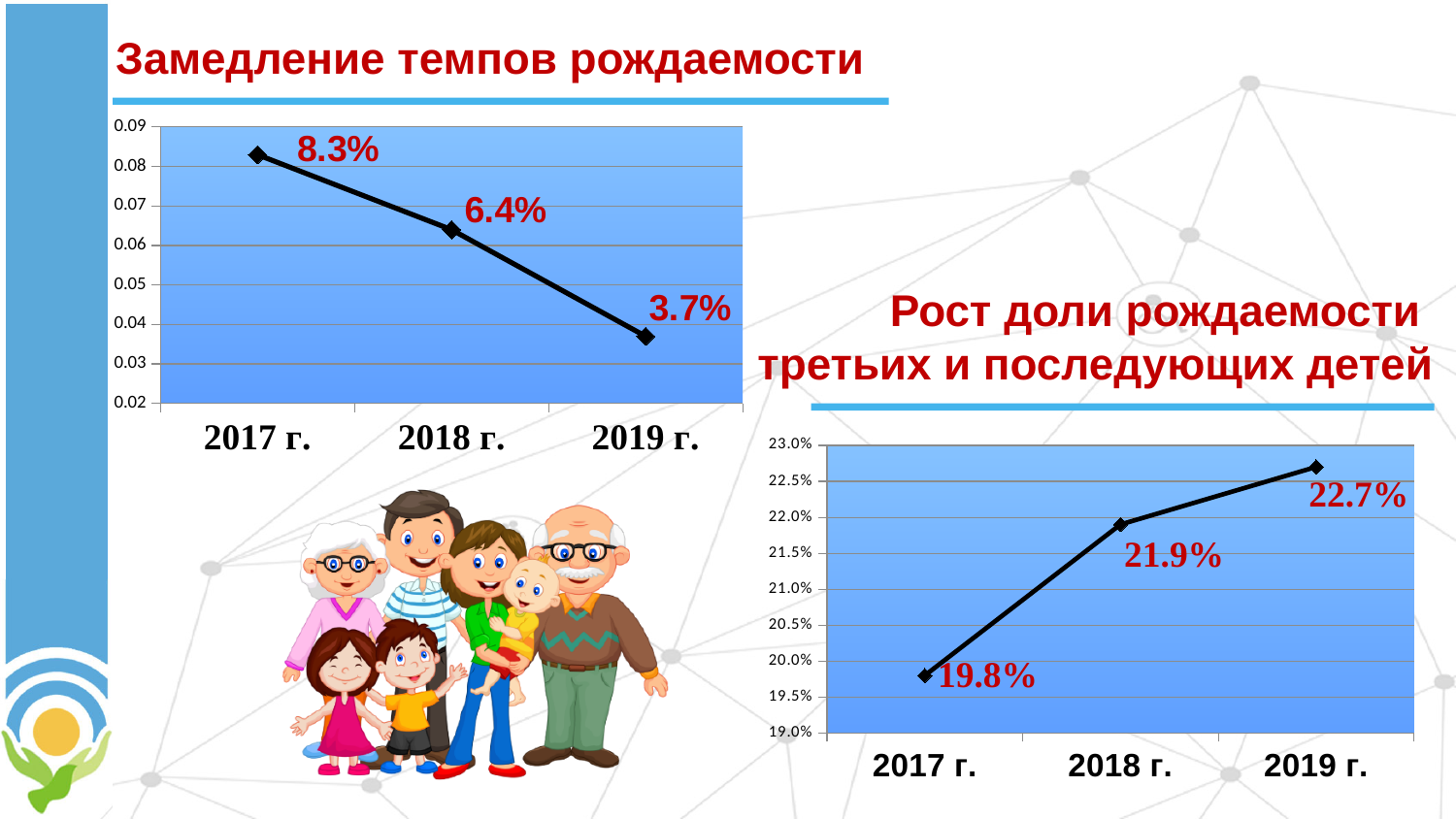
In the chart titled "Замедление темпов рождаемости", how many years are plotted? 3 In the chart titled "Замедление темпов рождаемости", what is the value for 2018 г.? 6.4% In the chart titled "Рост доли рождаемости третьих и последующих детей", what is the difference between the values for 2018 г. and 2019 г.? 0.8% In the chart titled "Замедление темпов рождаемости", do the values rise or fall from 2017 г. to 2019 г.? fall In the chart titled "Замедление темпов рождаемости", what is the difference between the values for 2017 г. and 2019 г.? 4.6% In the chart titled "Рост доли рождаемости третьих и последующих детей", which year has the highest value? 2019 г. In the chart titled "Рост доли рождаемости третьих и последующих детей", what is the value for 2017 г.? 19.8% How many charts are shown on the slide? 2 In the chart titled "Рост доли рождаемости третьих и последующих детей", which is larger, the value for 2017 г. or 2018 г.? 2018 г. In the chart titled "Замедление темпов рождаемости", which year has the lowest value? 2019 г. What kind of chart is the one titled "Замедление темпов рождаемости"? line chart In the chart titled "Рост доли рождаемости третьих и последующих детей", do the values rise or fall from 2017 г. to 2019 г.? rise